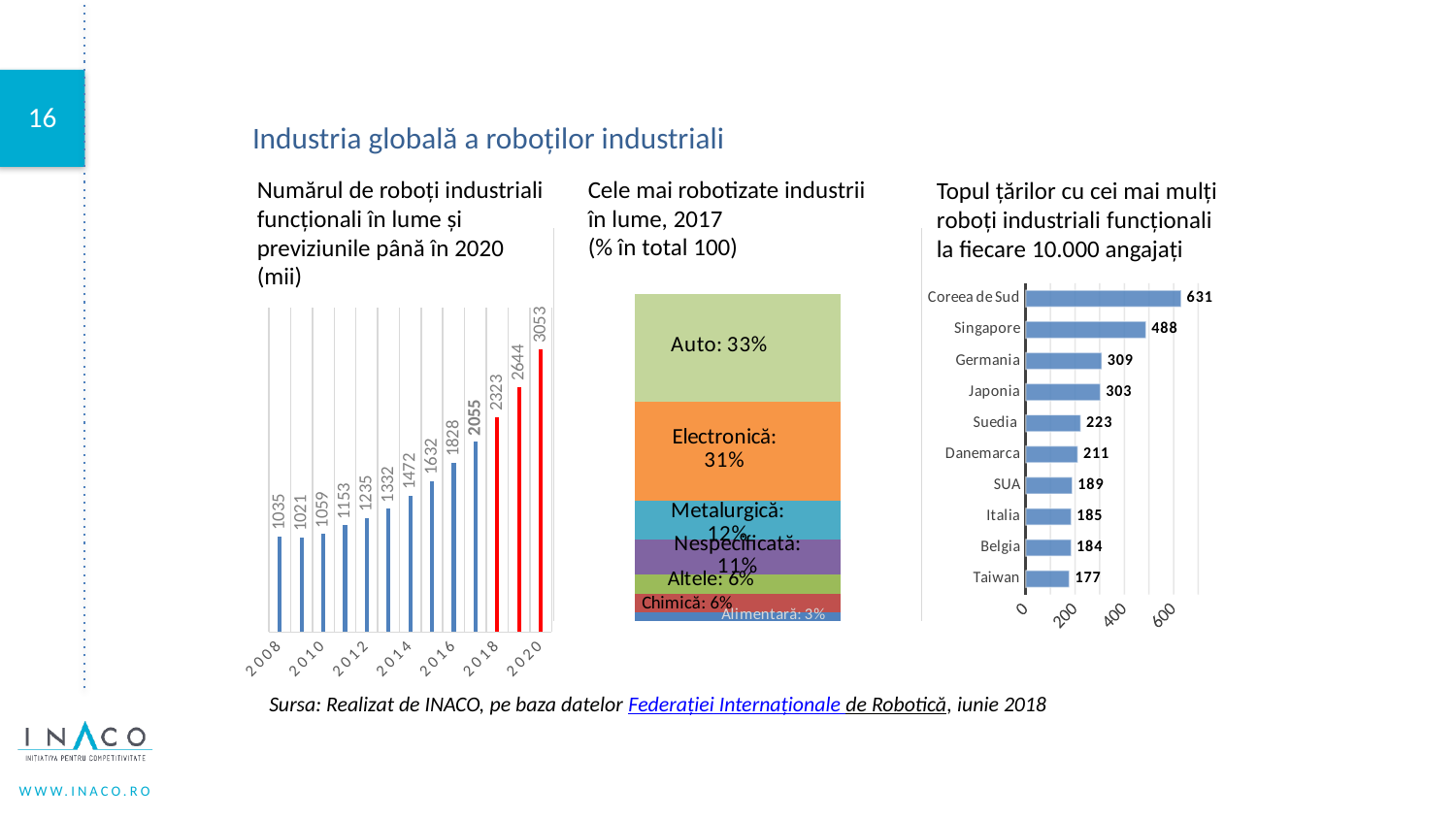
In the chart 'Cele mai robotizate industrii în lume, 2017', what share does Auto have? 33% In the chart 'Topul țărilor cu cei mai mulți roboți industriali', what is the value for Germania? 309 In the chart 'Cele mai robotizate industrii în lume, 2017', which industry has the smallest share? Alimentară In the chart 'Numărul de roboți industriali funcționali în lume', what is the value for 2008? 1035 In the chart 'Topul țărilor cu cei mai mulți roboți industriali', which country has the highest value? Coreea de Sud In the chart 'Topul țărilor cu cei mai mulți roboți industriali', what is the difference between Coreea de Sud and Singapore? 143 In the chart 'Numărul de roboți industriali funcționali în lume', how many bars are plotted? 13 In the chart 'Numărul de roboți industriali funcționali în lume', which year has the lowest value? 2009 In the chart 'Numărul de roboți industriali funcționali în lume', what is the value for 2020? 3053 In the chart 'Numărul de roboți industriali funcționali în lume', do the values generally rise or fall from 2010 to 2020? rise In the chart 'Numărul de roboți industriali funcționali în lume', what is the difference between the 2020 value and the 2008 value? 2018 In the chart 'Cele mai robotizate industrii în lume, 2017', what is the difference between the Auto share and the Electronică share? 2%